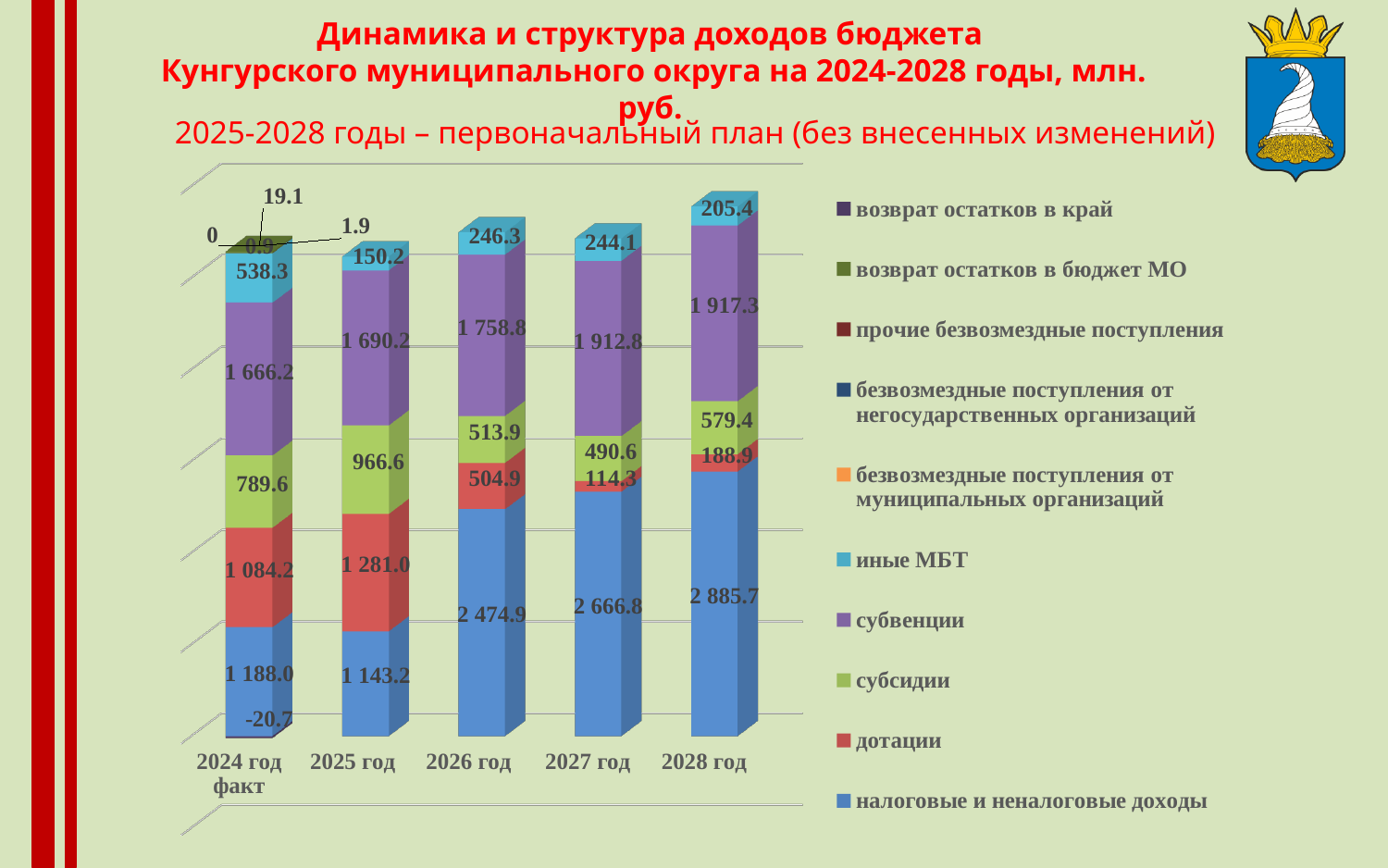
Which is larger: субвенции in 2027 год or in 2028 год? 2028 год What is the value of налоговые и неналоговые доходы for 2028 год? 2 885.7 Do the values of налоговые и неналоговые доходы rise or fall from 2025 год to 2028 год? Rise What kind of chart is shown on the slide? Stacked bar chart In which year is the value of налоговые и неналоговые доходы the highest? 2028 год How many years (categories) are shown on the x axis? 5 How many series does the legend list? 10 In which year is the value of дотации the lowest? 2027 год What is the value of субвенции for 2026 год? 1 758.8 What is the value of иные МБТ for 2024 год факт? 538.3 What is the difference between субсидии in 2028 год and 2027 год? 88.8 What is the value of дотации for 2025 год? 1 281.0